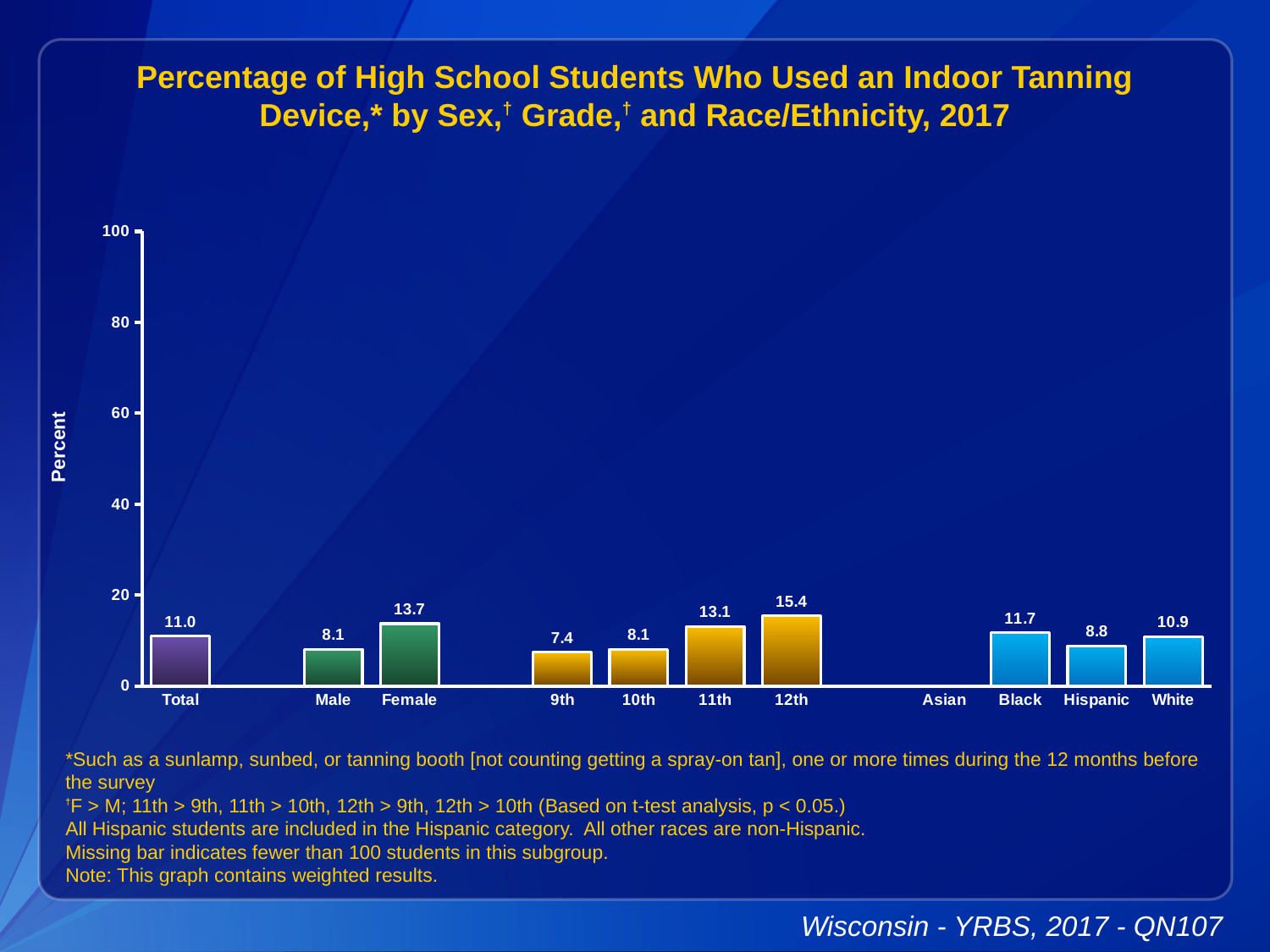
What kind of chart is shown? bar chart Is the value for 11th grade greater or less than 20? less What is the value for Total? 11.0 Which category has the highest value? 12th How many bars are plotted on the chart? 10 Which is larger, the value for Black or the value for White? Black Do the values rise or fall from 9th grade to 12th grade? rise What is the value for Female? 13.7 Which category has the lowest value among the bars shown? 9th What is the value for 12th grade? 15.4 What is the difference between the Female and Male values? 5.6 What is the value for Hispanic? 8.8